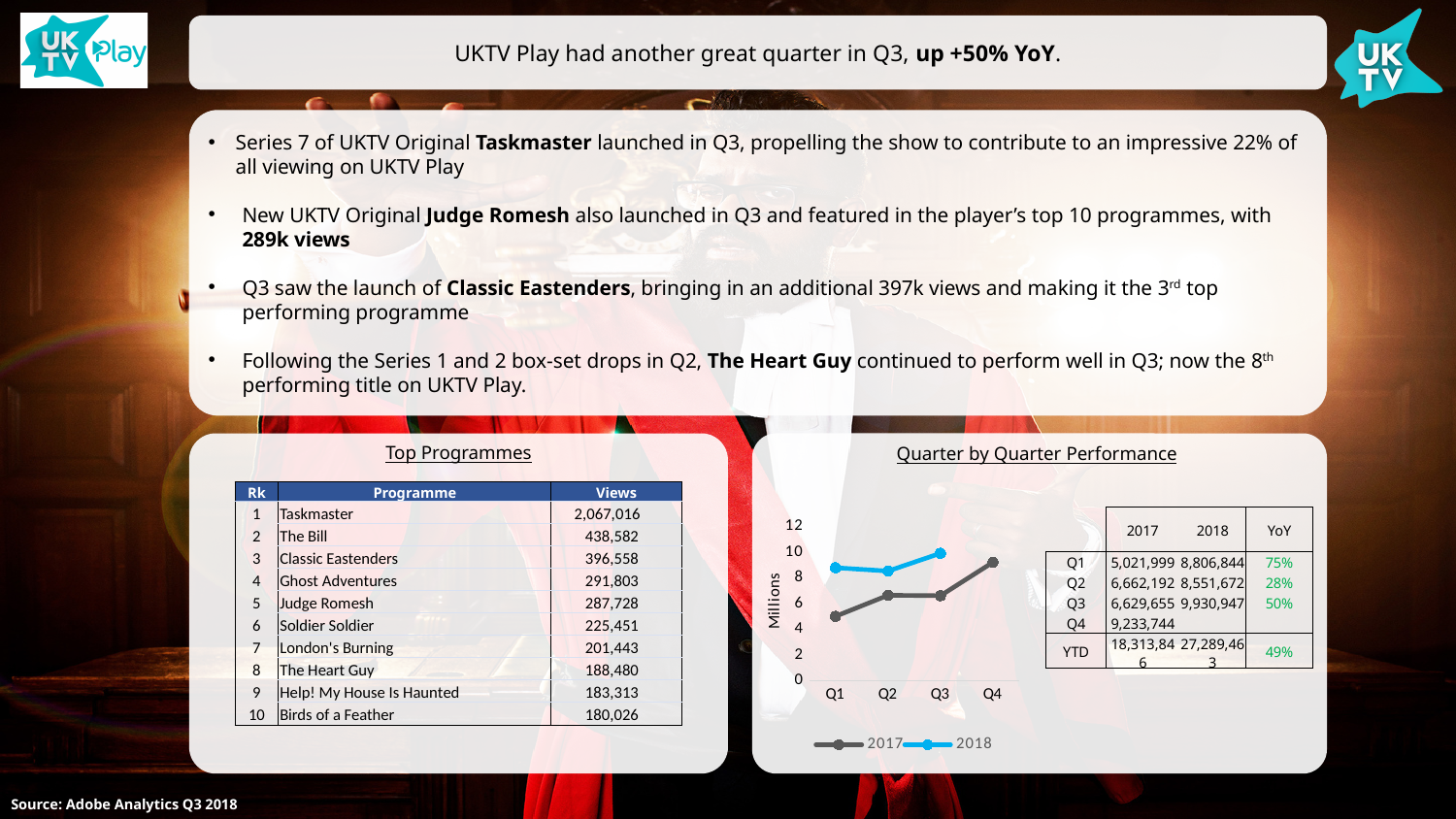
How many series does the legend of the Quarter by Quarter Performance chart list? 2 In the Quarter by Quarter Performance chart, which series has the higher value in Q1, 2017 or 2018? 2018 In the Quarter by Quarter Performance chart, which quarter has the lowest value for the 2017 series? Q1 In the Quarter by Quarter Performance chart, is the 2018 value for Q3 greater or less than 8? greater What unit label is shown on the y axis of the Quarter by Quarter Performance chart? Millions How many quarters are shown on the x axis of the Quarter by Quarter Performance chart? 4 In the Quarter by Quarter Performance chart, which series has the higher value in Q3, 2017 or 2018? 2018 What type of chart is the Quarter by Quarter Performance chart? line chart In the Quarter by Quarter Performance chart, which quarter has the highest value for the 2018 series? Q3 In the Quarter by Quarter Performance chart, does the 2017 series rise or fall overall from Q1 to Q4? rise In the Quarter by Quarter Performance chart, is the 2017 value for Q1 greater or less than 6? less In the Quarter by Quarter Performance chart, is the 2017 value for Q4 greater or less than 8? greater